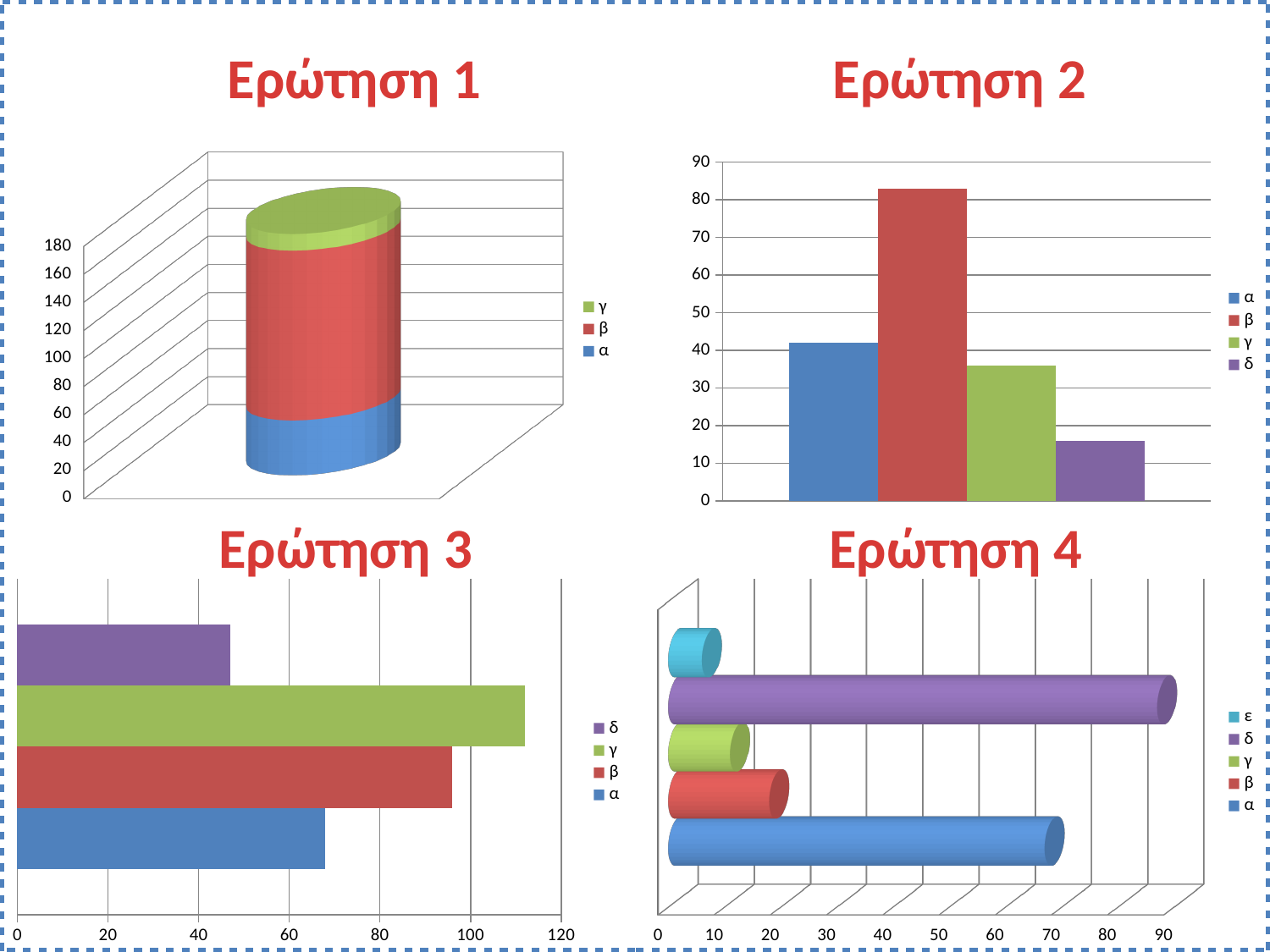
How many entries does the legend of the Ερώτηση 4 chart list? 5 In the Ερώτηση 3 chart, which category has the longest bar? γ In the Ερώτηση 2 chart, which category has the lowest bar? δ In the Ερώτηση 4 chart, which category has the longest bar? δ In the Ερώτηση 4 chart, is the value for α greater or less than 60? greater In the Ερώτηση 3 chart, is the value for γ greater or less than 100? greater In the Ερώτηση 3 chart, which category has the shortest bar? δ In the Ερώτηση 2 chart, which category has the highest bar? β In the Ερώτηση 2 chart, is the value for δ greater or less than 20? less What kind of chart is shown under Ερώτηση 2? bar chart How many categories does the legend of the Ερώτηση 2 chart list? 4